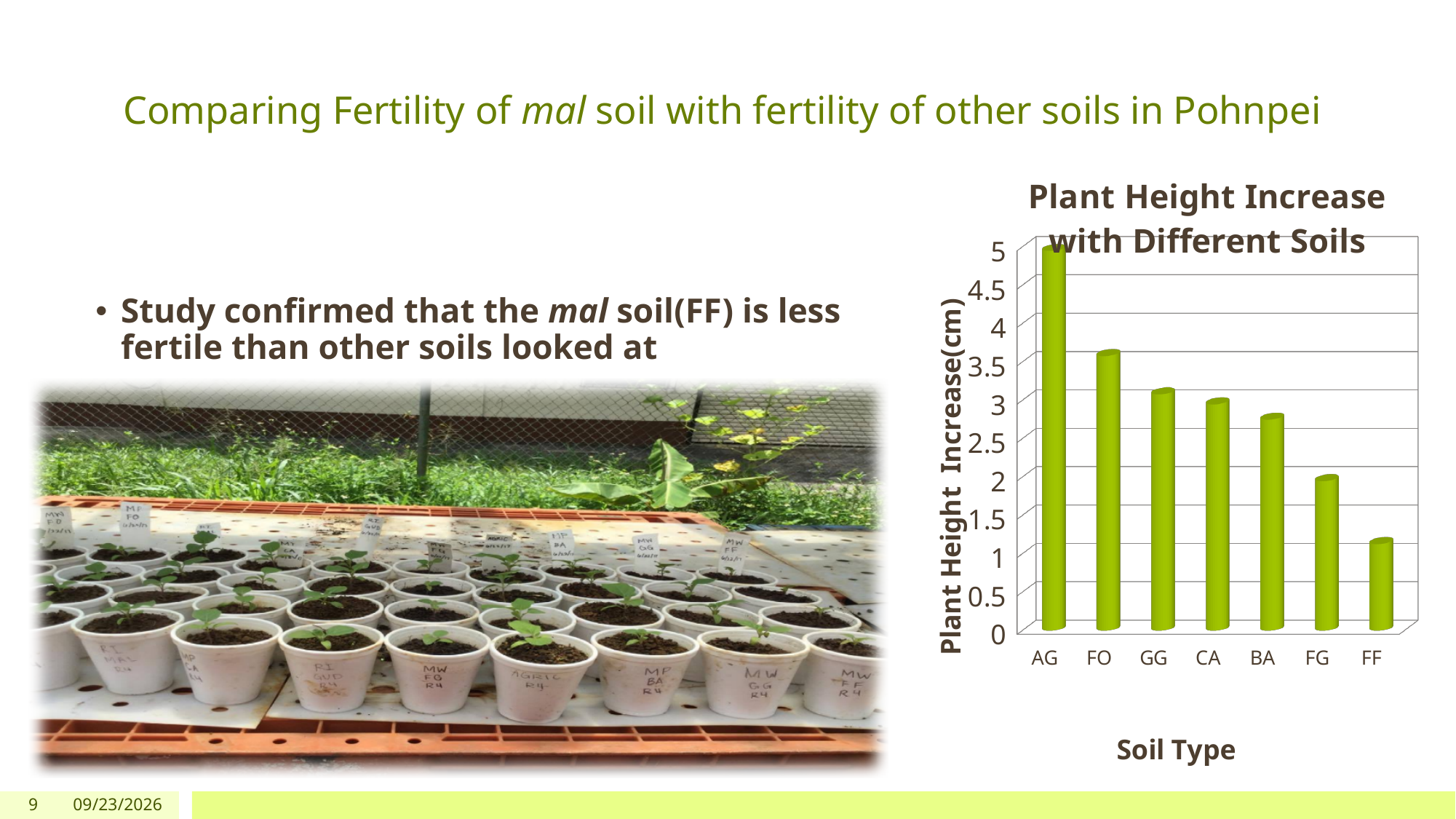
Is the plant height increase for FF greater or less than 1.5? less Is the plant height increase for FG greater or less than 2.5? less What type of chart is shown on the slide? bar chart Do the plant height increase values rise or fall from AG to FF along the x axis? fall Is the plant height increase for AG greater or less than 4.5? greater Which soil type has the highest plant height increase? AG What is the title of the chart? Plant Height Increase with Different Soils Which has a larger plant height increase, FO or FG? FO How many soil types are plotted on the chart? 7 What is the label of the x axis? Soil Type Which soil type has the lowest plant height increase? FF